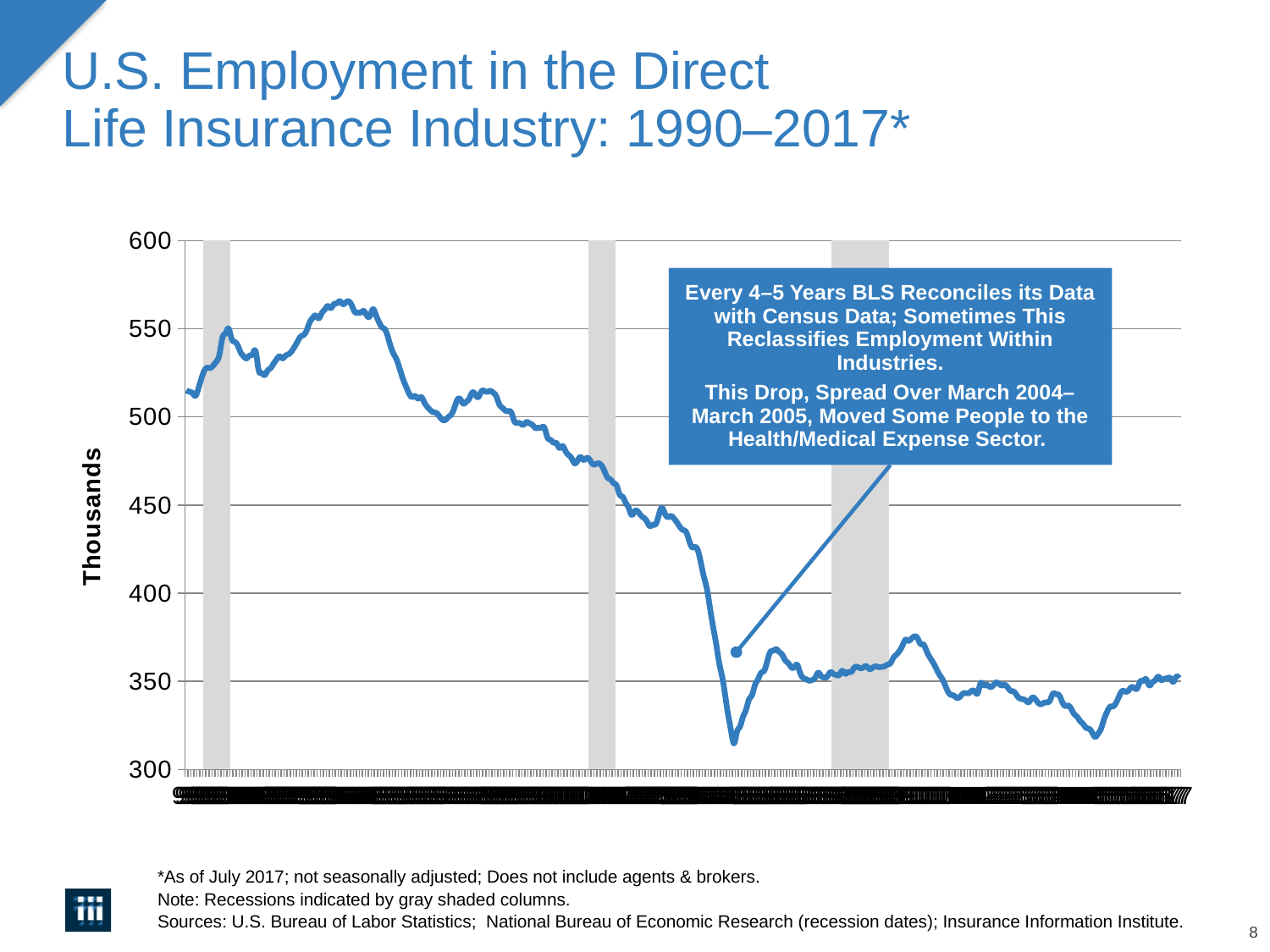
Is the value at the left end of the line greater or less than the value at the right end of the line? greater Overall, does the employment line rise or fall from the left end of the chart to the right end? fall Is the lowest point reached by the line greater or less than 350? less Is the value at the left end of the line (the start of the series) greater or less than 500? greater How many gray shaded recession columns appear on the chart? 3 What is the lowest value shown on the vertical axis? 300 What is the label on the vertical axis of the chart? Thousands What is the highest value shown on the vertical axis? 600 Is the highest point reached by the line greater or less than 550? greater What is the title of the chart? U.S. Employment in the Direct Life Insurance Industry: 1990–2017* What kind of chart is shown on the slide? line chart